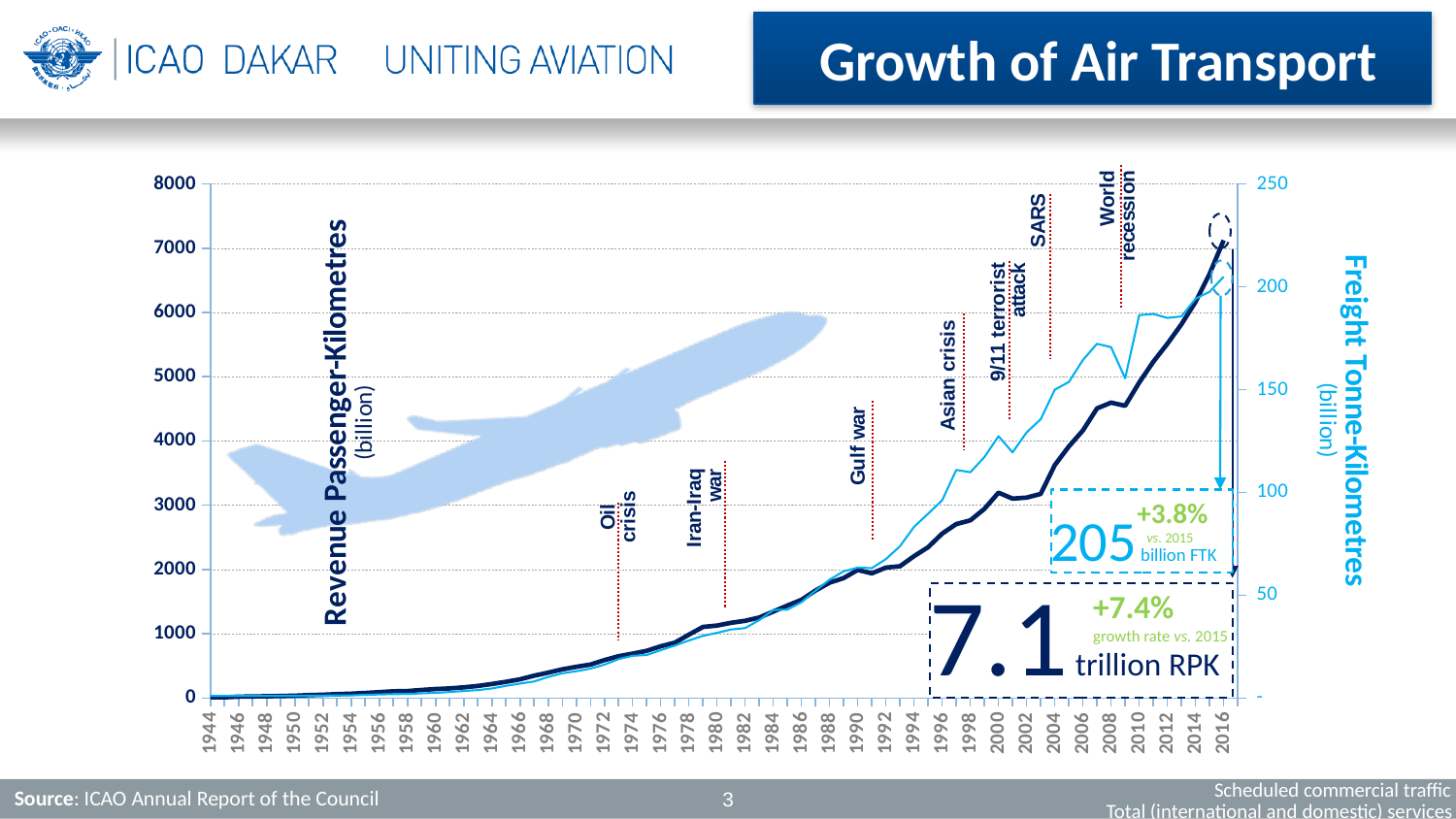
What kind of chart is shown on the slide? line chart Is the Freight Tonne-Kilometres value for 2008 greater or less than 200? less According to the callout on the chart, how many trillion RPK were recorded in 2016? 7.1 trillion RPK What is the title of the slide containing the chart? Growth of Air Transport Is the Revenue Passenger-Kilometres value for 2016 greater or less than 6000? greater What quantity is plotted on the left vertical axis of the chart? Revenue Passenger-Kilometres (billion) According to the callout on the chart, how many billion FTK were recorded in 2016? 205 billion FTK How many historical events are annotated on the chart (Oil crisis, Iran-Iraq war, Gulf war, Asian crisis, 9/11 terrorist attack, SARS, World recession)? 7 What growth rate vs. 2015 is shown for RPK on the chart? +7.4% Do Revenue Passenger-Kilometres rise or fall over the period shown on the chart? rise What quantity is plotted on the right vertical axis of the chart? Freight Tonne-Kilometres (billion) What growth vs. 2015 is shown for FTK on the chart? +3.8%